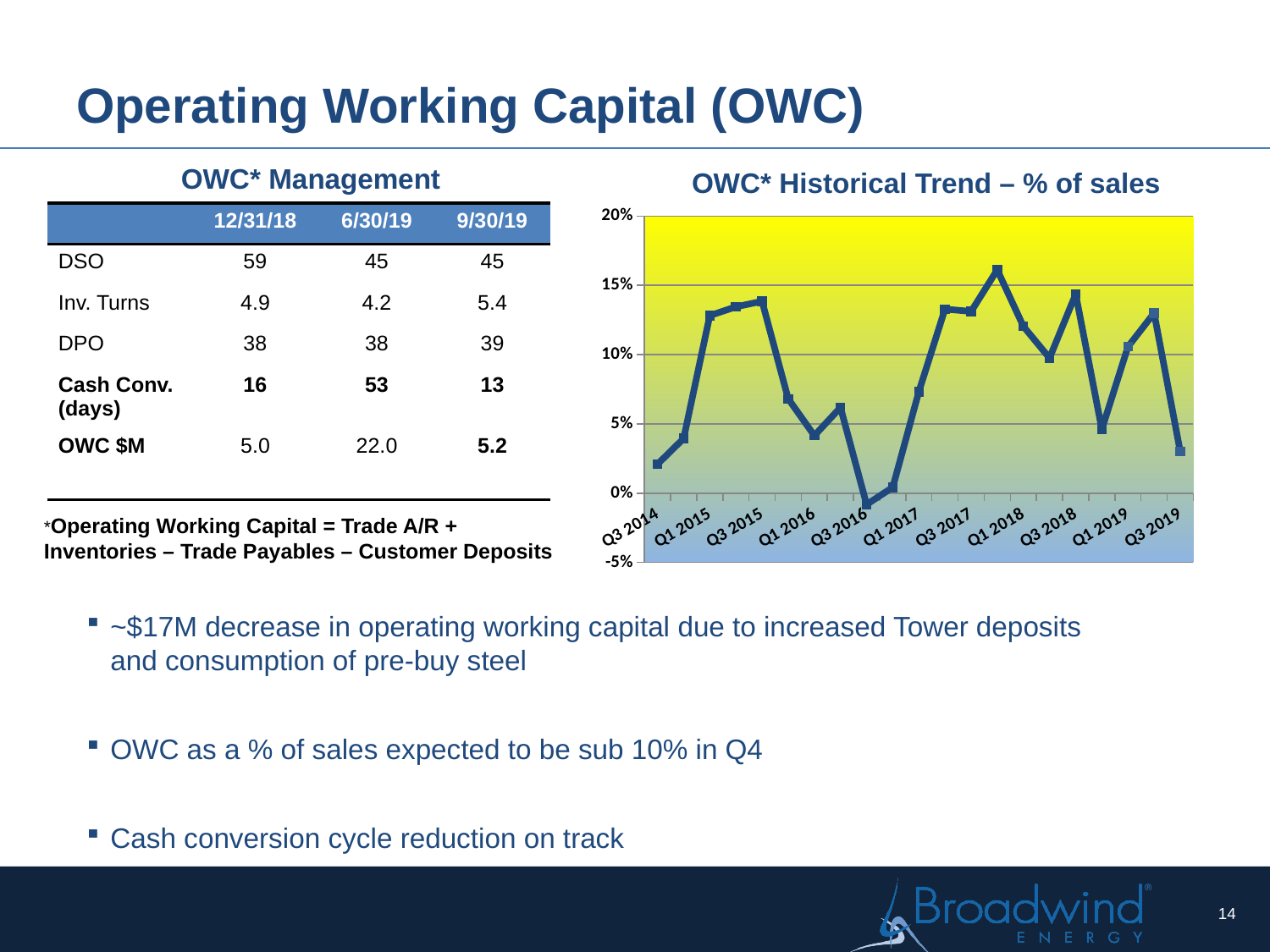
In the OWC* Historical Trend chart, is the value for Q3 2019 greater or less than 5%? less In the OWC* Historical Trend chart, is the value for Q3 2014 greater or less than 5%? less In the OWC* Historical Trend chart, which is larger, the value for Q3 2018 or the value for Q3 2019? Q3 2018 In the OWC* Historical Trend chart, is the value for Q3 2017 greater or less than 10%? greater What is the highest value shown on the y axis of the OWC* Historical Trend chart? 20% How many quarter labels are shown on the x axis of the OWC* Historical Trend chart? 11 In the OWC* Historical Trend chart, which is larger, the value for Q3 2015 or the value for Q3 2016? Q3 2015 What kind of chart is the OWC* Historical Trend chart? line chart In the OWC* Historical Trend chart, do the values rise or fall from Q3 2014 to Q3 2015? rise What is the title of the chart on the right side of the slide? OWC* Historical Trend – % of sales